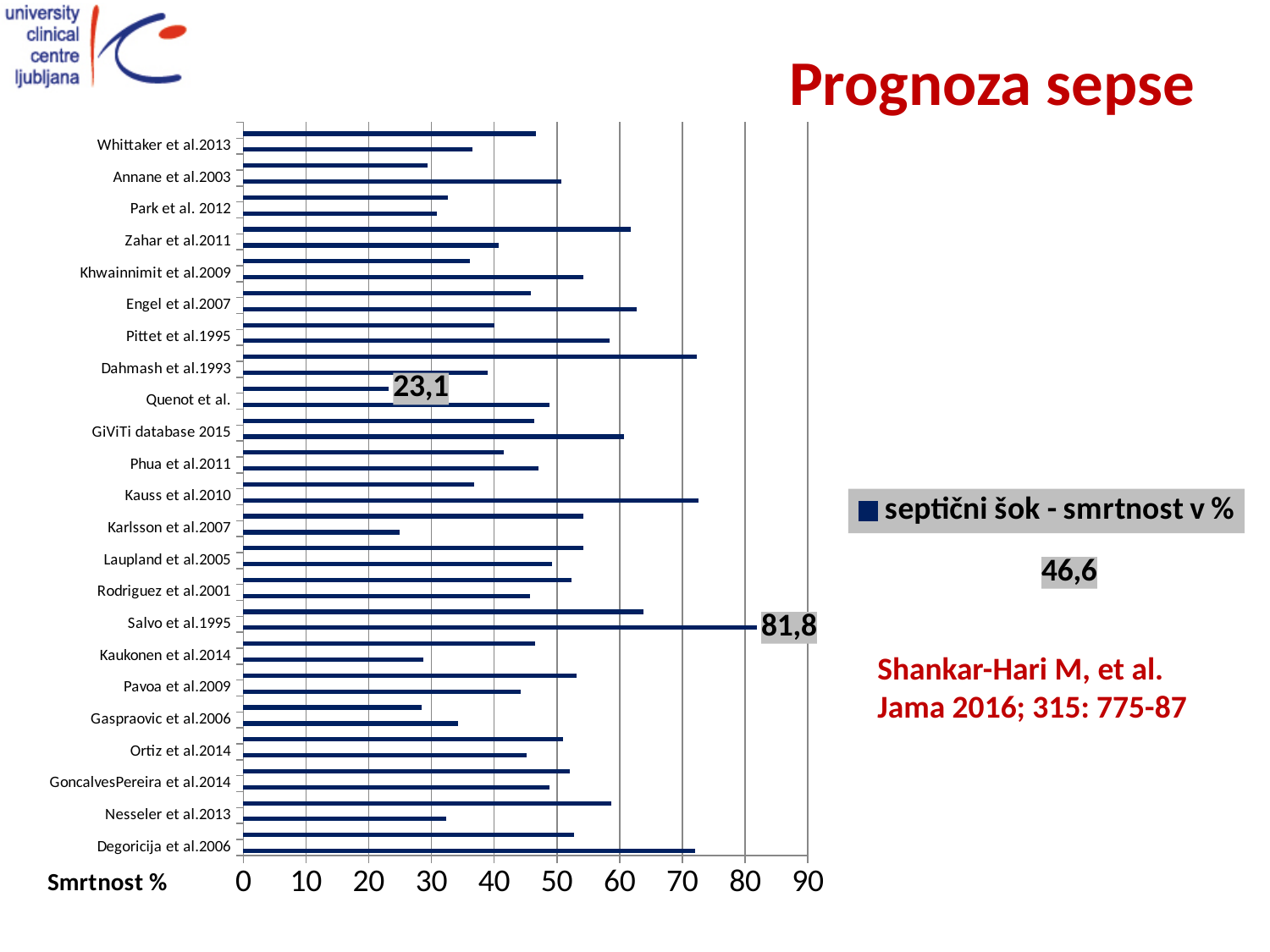
Is the value for Pittet et al.1995 greater or less than 50? greater Is the value for Gaspraovic et al.2006 greater or less than 40? less Which has the larger mortality value, Salvo et al.1995 or Karlsson et al.2007? Salvo et al.1995 Which study has the highest mortality value in the chart? Salvo et al.1995 What is the mortality value labelled for Salvo et al.1995? 81,8 How many series does the legend list? 1 Is the value for Karlsson et al.2007 greater or less than 30? less What is the title of the slide's chart? Prognoza sepse What kind of chart is shown on the slide? bar chart What series does the chart legend list? septični šok - smrtnost v %